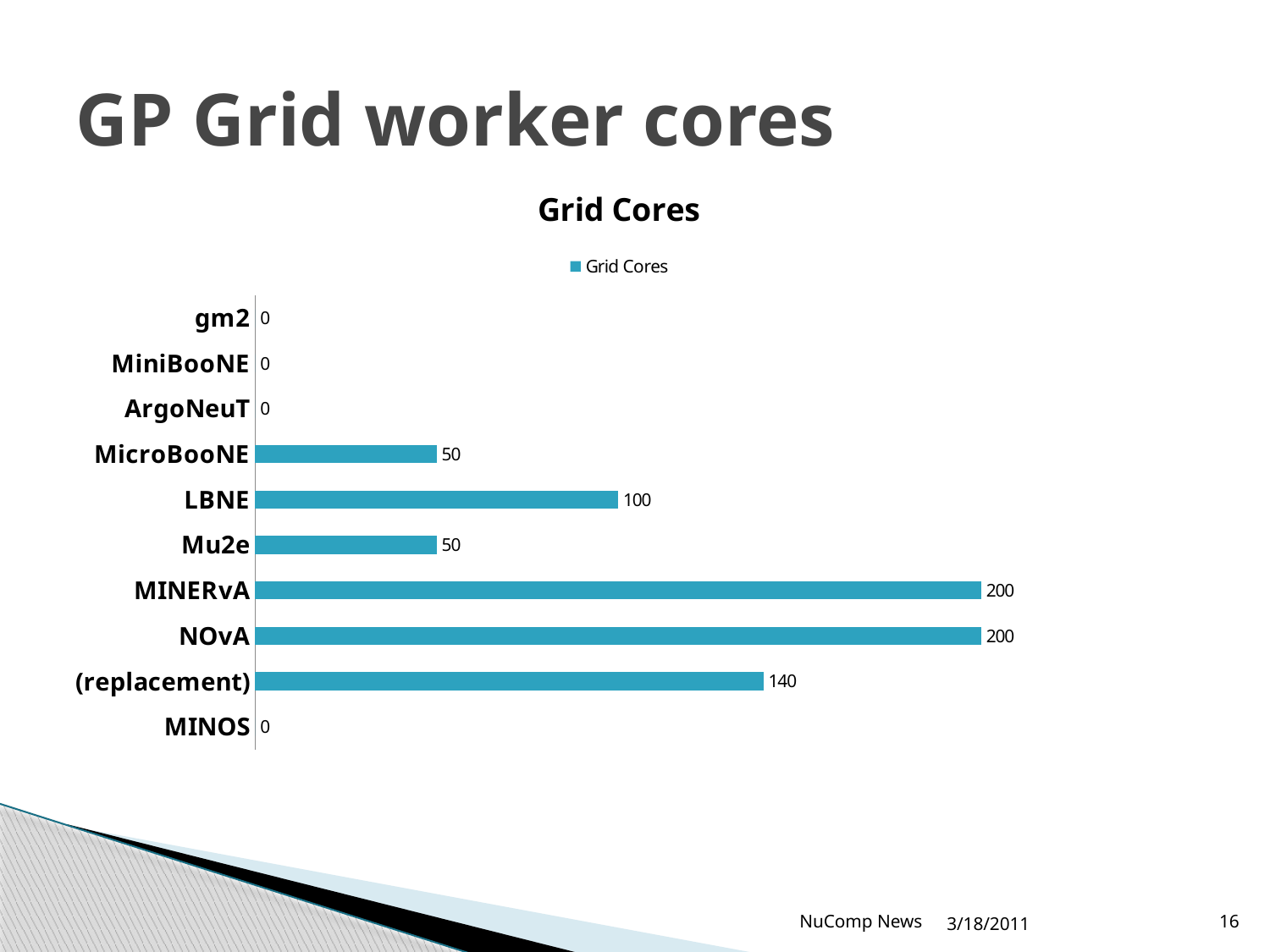
How many categories are shown in the Grid Cores chart? 10 What is the value for MicroBooNE in the Grid Cores chart? 50 Which has a larger value, LBNE or MicroBooNE? LBNE What is the value for LBNE in the Grid Cores chart? 100 What is the value for (replacement) in the Grid Cores chart? 140 What is the value for NOvA in the Grid Cores chart? 200 What kind of chart is shown on the slide? bar chart What is the difference between the values for LBNE and Mu2e? 50 How many series does the legend of the Grid Cores chart list? 1 Which has a larger value, (replacement) or NOvA? NOvA What is the value for MINOS in the Grid Cores chart? 0 What is the difference between the values for MINERvA and (replacement)? 60